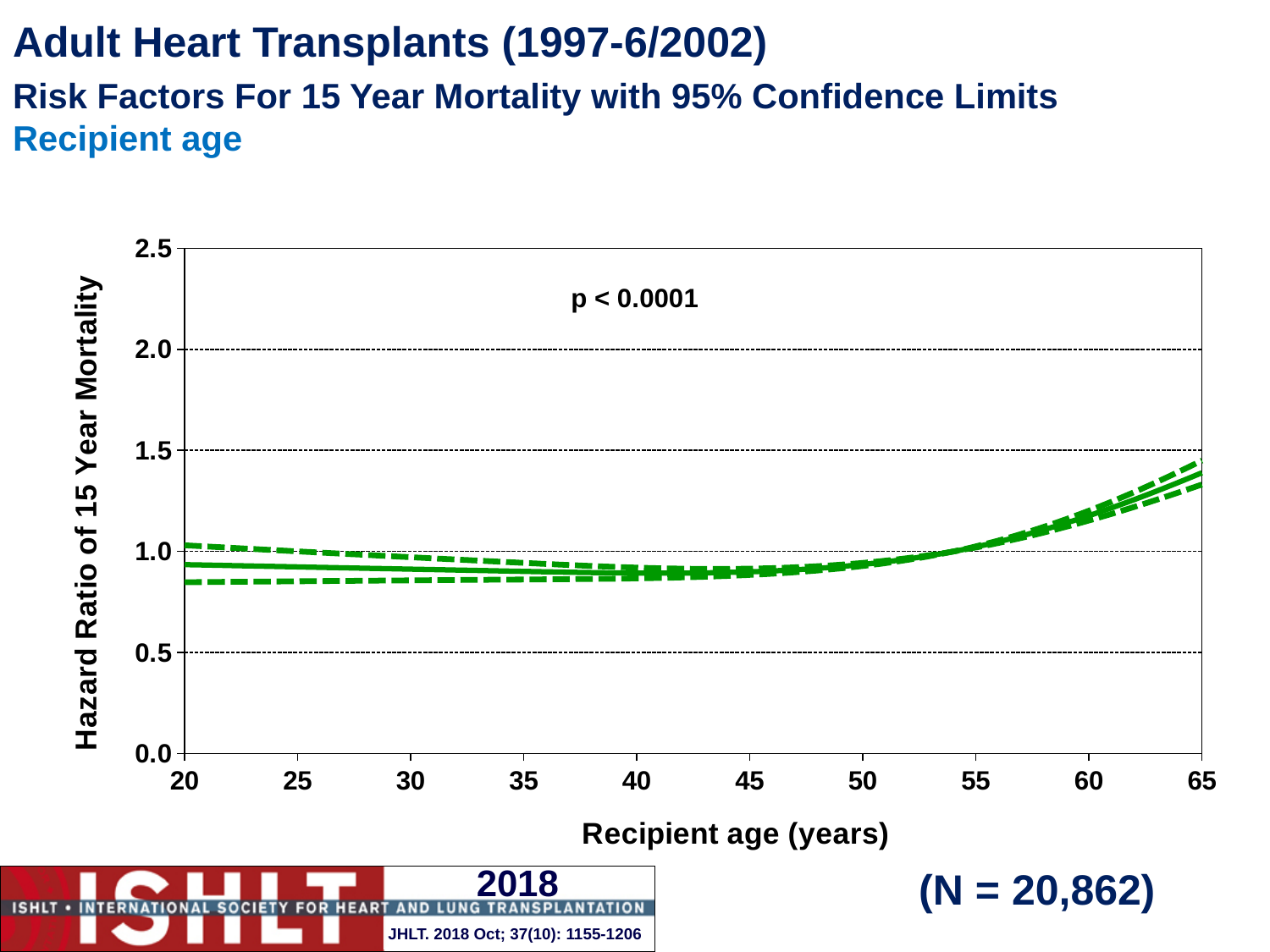
Is the hazard ratio at a recipient age of 65 greater or less than 1.5? less Does the hazard ratio rise or fall as recipient age increases from 20 to 40? fall How many tick labels are shown on the x axis? 10 Is the hazard ratio at a recipient age of 65 greater or less than 1.0? greater At which recipient age shown on the x axis is the hazard ratio highest? 65 Does the hazard ratio rise or fall as recipient age increases from 55 to 65? rise What is the p-value printed on the chart? p < 0.0001 Is the hazard ratio at a recipient age of 30 greater or less than 1.5? less What is the label of the x axis? Recipient age (years) What kind of chart is shown on the slide? line chart How many tick labels are shown on the y axis? 6